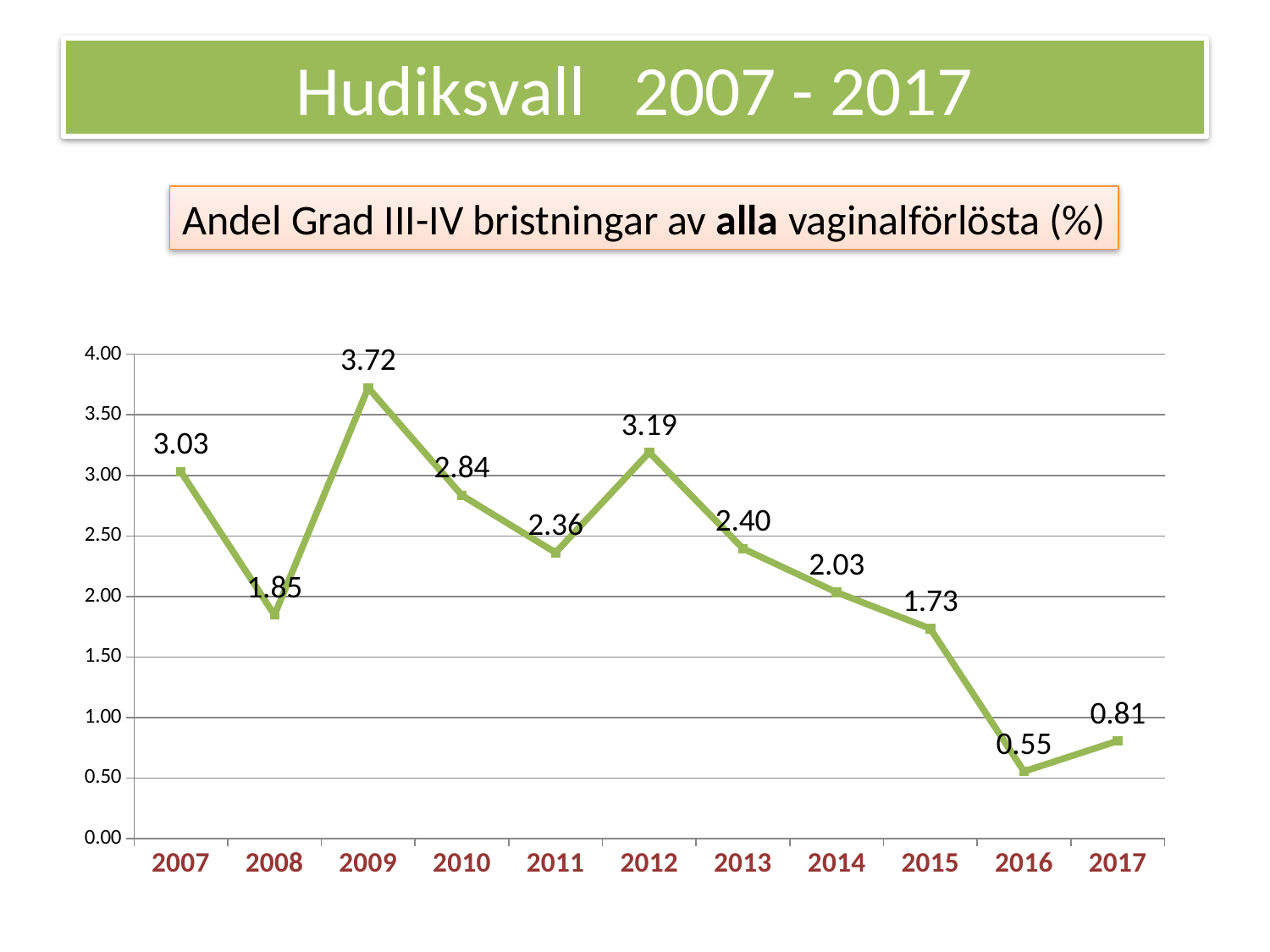
What is the value for 2016? 0.55 Is the value for 2015 greater or less than 2.00? less What is the value for 2012? 3.19 What is the difference between the values for 2007 and 2008? 1.18 What is the difference between the values for 2009 and 2016? 3.17 What is the value for 2009? 3.72 What kind of chart is shown? line chart Which year has the lowest value? 2016 Which is larger, the value for 2010 or the value for 2013? 2010 Do the values generally rise or fall from 2012 to 2016? fall How many years are plotted on the x axis? 11 Which year has the highest value? 2009